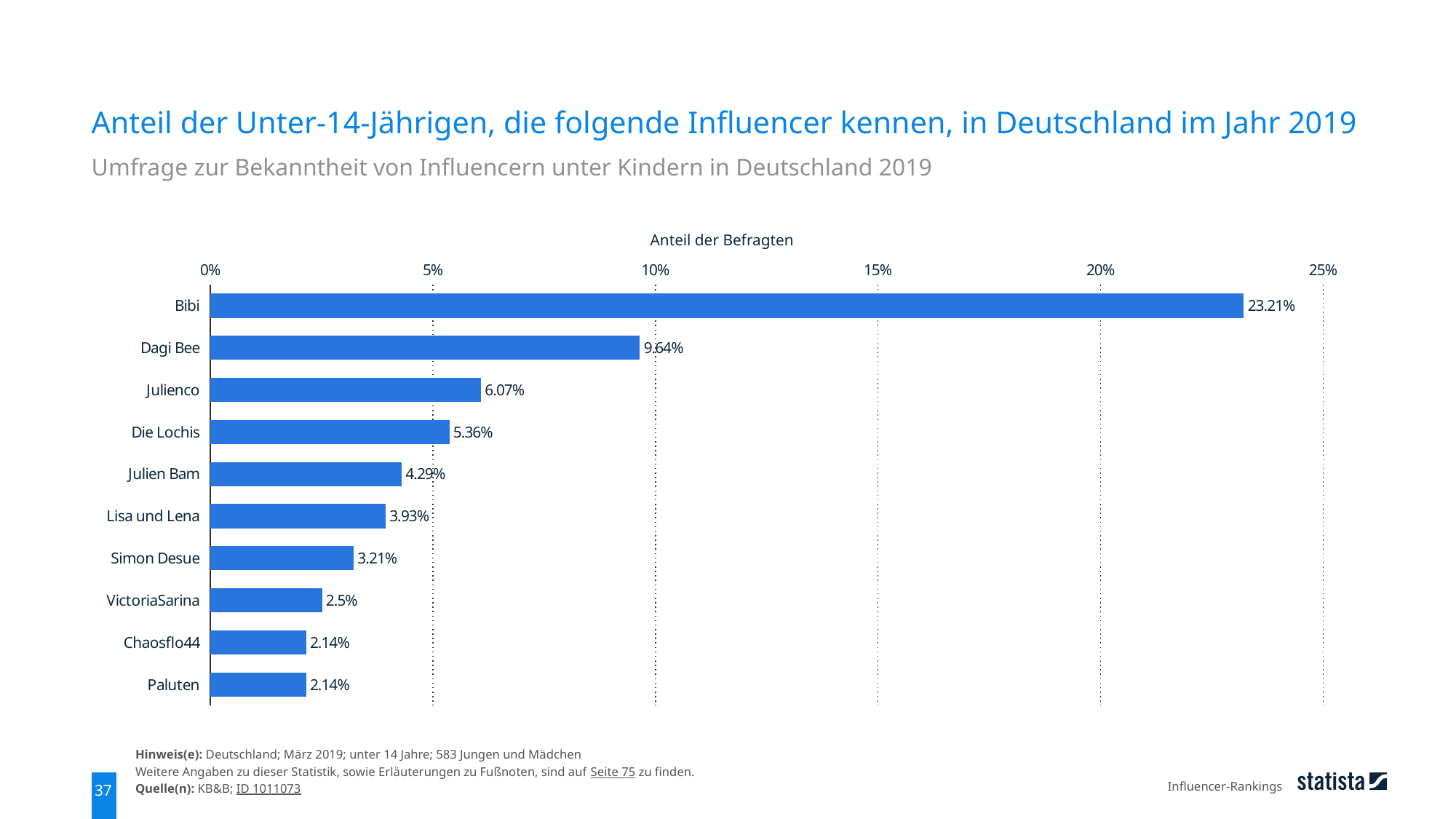
Is the value for Dagi Bee greater or less than 10%? less What is the value shown for Dagi Bee? 9.64% Which influencer has the lowest value on the chart? Chaosflo44 and Paluten (both 2.14%) What is the difference between the values for Bibi and Dagi Bee? 13.57 percentage points What is the difference between the values for Julienco and Die Lochis? 0.71 percentage points What percentage of respondents know Lisa und Lena? 3.93% How many influencers are shown on the chart? 10 What is the label of the horizontal axis? Anteil der Befragten What share of under-14-year-olds know Bibi? 23.21% Which influencer has the highest share of respondents who know them? Bibi What type of chart is shown on the slide? Bar chart Which has a higher value, Julien Bam or Simon Desue? Julien Bam